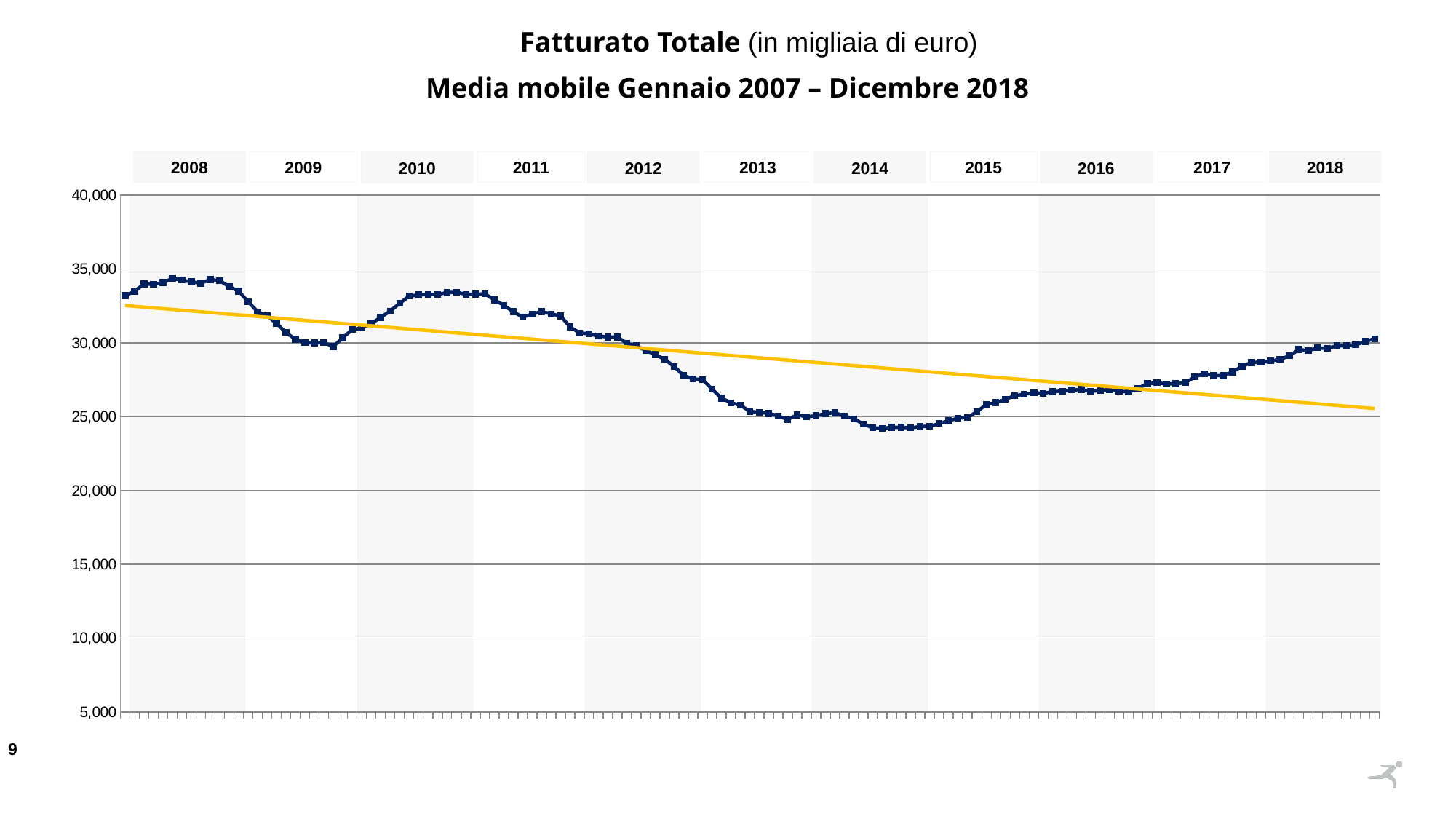
What kind of chart is shown on the slide? line chart Is the value of the blue line in 2008 greater or less than 30,000? greater How many year labels are shown along the top of the chart? 11 Which year has higher values on the blue line, 2008 or 2014? 2008 Which year has higher values on the blue line, 2013 or 2017? 2017 Does the blue moving-average line rise or fall between 2015 and 2018? rise Is the value of the blue line in 2013 greater or less than 30,000? less What colour is the straight trend line on the chart? yellow Does the yellow trend line rise or fall from left to right? fall In which year does the blue moving-average line reach its lowest values? 2014 What is the title of the chart? Fatturato Totale (in migliaia di euro) Media mobile Gennaio 2007 – Dicembre 2018